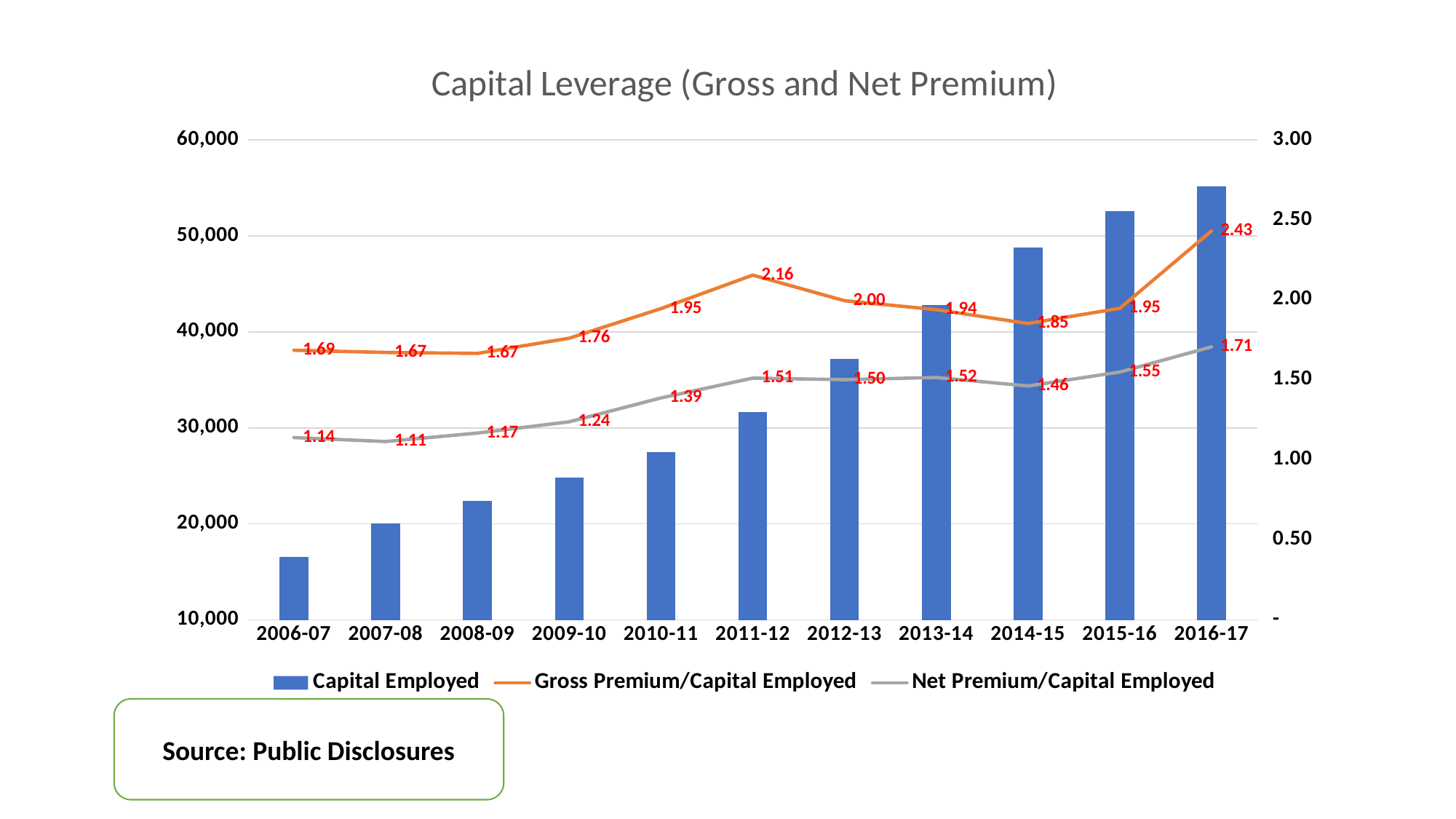
In which year is Net Premium/Capital Employed lowest? 2007-08 How many series does the legend list? 3 What is the Net Premium/Capital Employed value for 2016-17? 1.71 What is the Gross Premium/Capital Employed value for 2011-12? 2.16 Is the Capital Employed bar for 2006-07 greater or less than 20,000? less By how much did Gross Premium/Capital Employed increase from 2015-16 to 2016-17? 0.48 What kind of chart is this? Combination bar and line chart Is the Capital Employed bar for 2016-17 greater or less than 50,000? greater How many years are shown on the x axis? 11 In which year is Gross Premium/Capital Employed highest? 2016-17 Which year has the higher Net Premium/Capital Employed, 2012-13 or 2013-14? 2013-14 Does Capital Employed rise or fall from 2006-07 to 2016-17? Rise